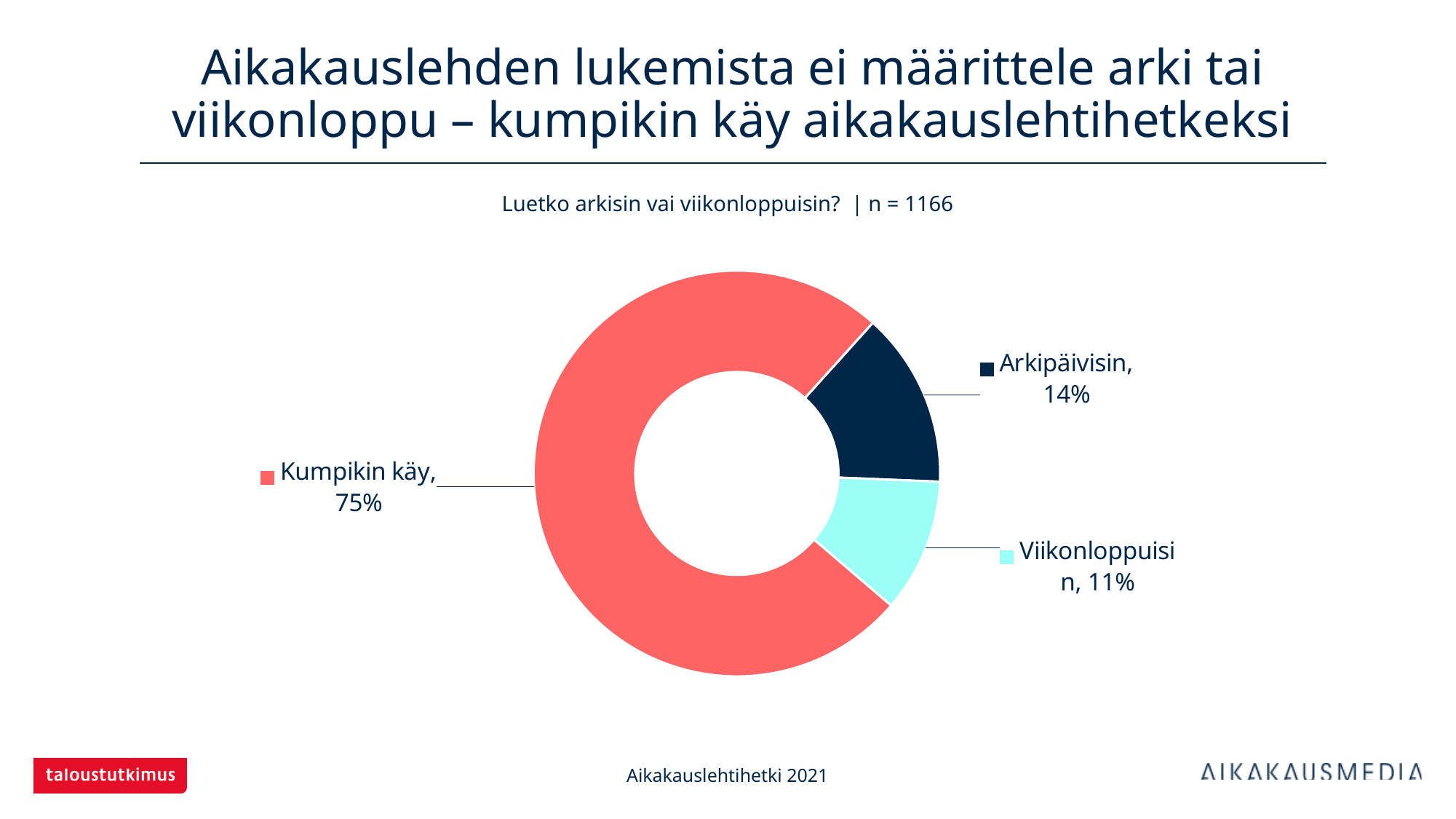
What kind of chart is shown on the slide? Doughnut (pie) chart What is the difference in percentage points between "Kumpikin käy" and "Arkipäivisin"? 61 What is the difference in percentage points between "Arkipäivisin" and "Viikonloppuisin"? 3 Which category has the smallest share of the chart? Viikonloppuisin What is the sample size (n) stated for the survey question? 1166 What percentage of respondents answered "Kumpikin käy"? 75% What percentage of respondents answered "Viikonloppuisin"? 11% What colour is the "Kumpikin käy" slice? Red Which is larger, the share for "Arkipäivisin" or for "Viikonloppuisin"? Arkipäivisin How many categories are shown in the chart? 3 Which category has the largest share of the chart? Kumpikin käy What percentage of respondents answered "Arkipäivisin"? 14%